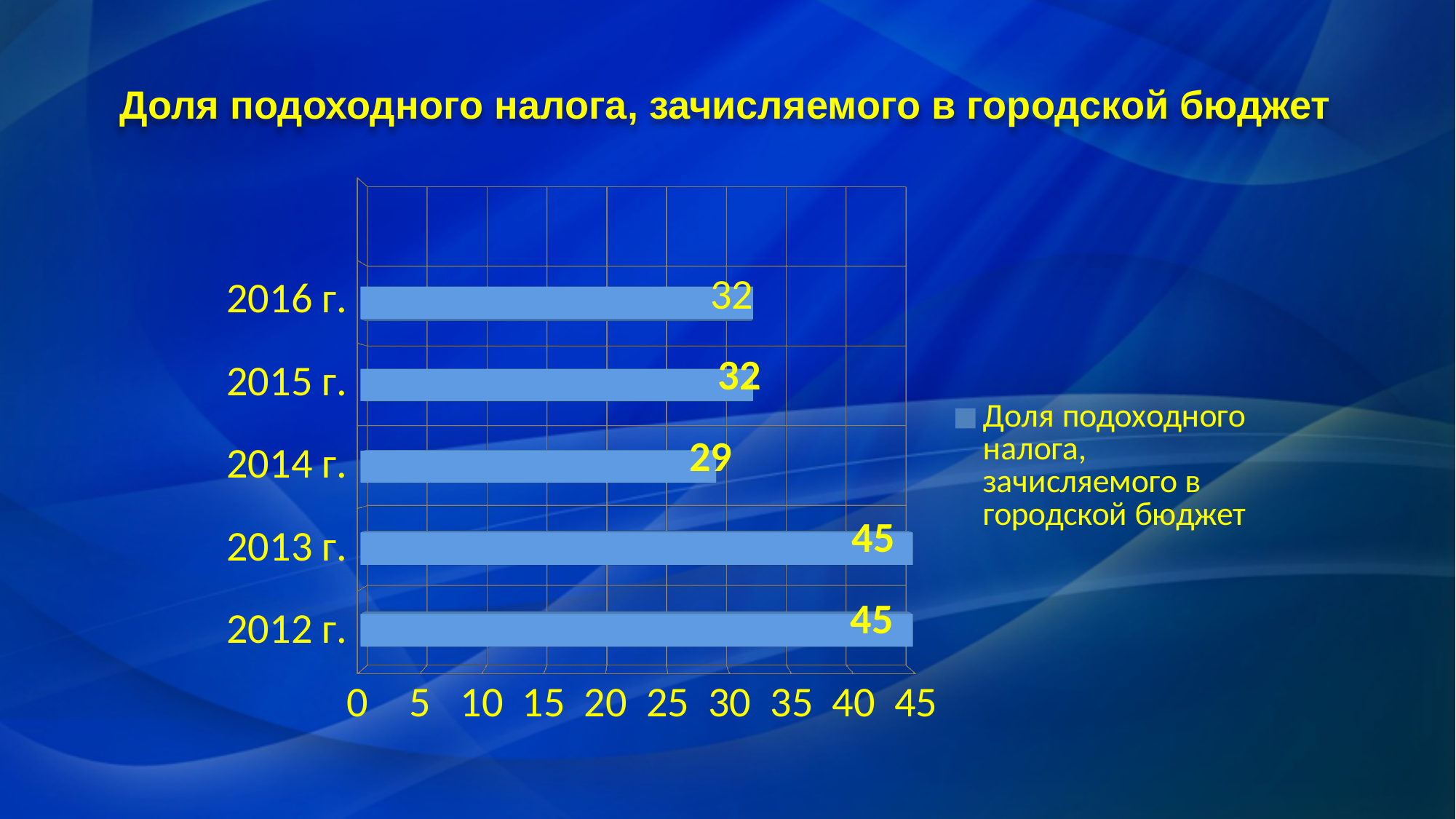
Is the value for 2014 г. greater or less than 30? less What is the difference between the values for 2012 г. and 2015 г.? 13 What is the value for 2016 г.? 32 What is the title of the chart? Доля подоходного налога, зачисляемого в городской бюджет What kind of chart is shown on the slide? bar chart What is the value for 2012 г.? 45 How many series does the legend list? 1 What is the value for 2014 г.? 29 What is the difference between the values for 2013 г. and 2014 г.? 16 How many years are shown on the chart? 5 Which year has the lowest value? 2014 г. Which is larger, the value for 2013 г. or the value for 2016 г.? 2013 г.